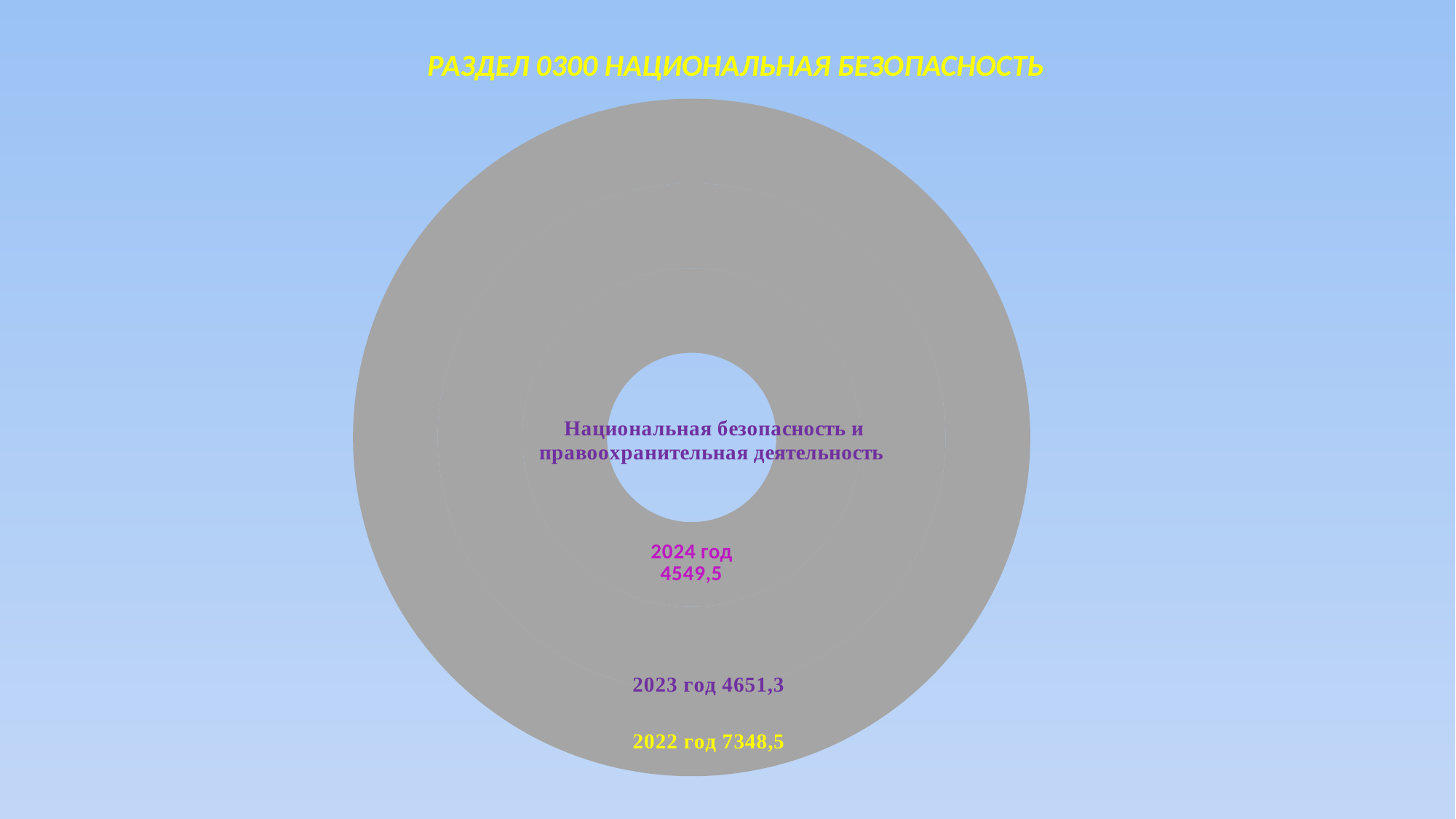
What is the value shown for 2022 год? 7348,5 Do the values rise or fall from 2022 год to 2024 год? Fall What is the value shown for 2023 год? 4651,3 What is the value shown for 2024 год? 4549,5 What kind of chart is shown on the slide? Doughnut (pie) chart Which is larger, the value for 2023 год or the value for 2024 год? 2023 год Which year has the lowest value on the chart? 2024 год What is the difference between the values for 2022 год and 2023 год? 2697,2 How many years are labelled with values on the chart? 3 What is the difference between the values for 2023 год and 2024 год? 101,8 What is the title of the slide? РАЗДЕЛ 0300 НАЦИОНАЛЬНАЯ БЕЗОПАСНОСТЬ Which year has the highest value on the chart? 2022 год